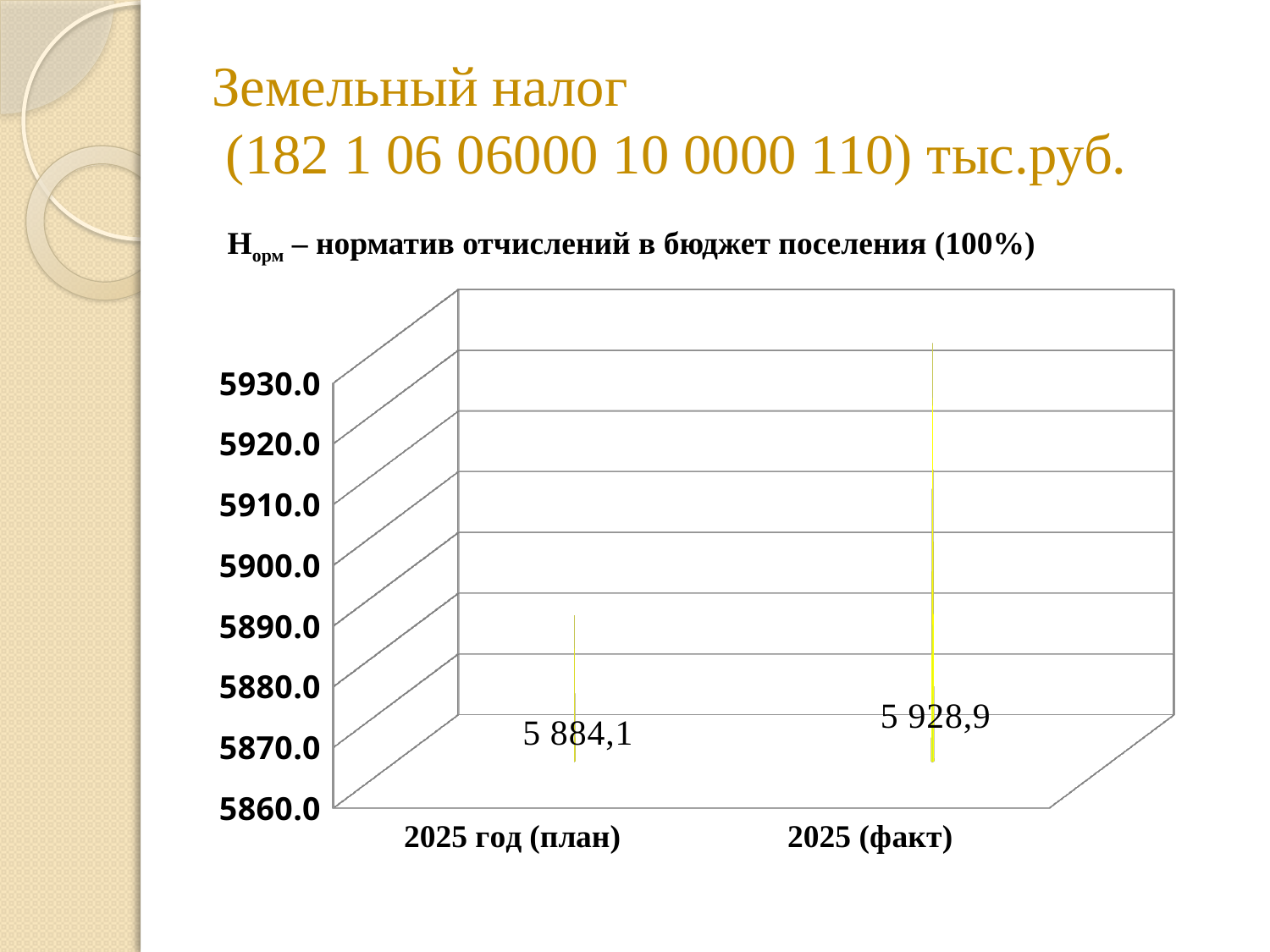
What kind of chart is shown on the slide? bar chart What is the difference between the value for 2025 (факт) and the value for 2025 год (план)? 44,8 Is the value for 2025 (факт) greater or less than 5900.0? greater Is the value for 2025 год (план) greater or less than 5900.0? less Which category has the lower value? 2025 год (план) Do the values rise or fall from 2025 год (план) to 2025 (факт)? rise What is the value for 2025 (факт)? 5 928,9 What is the lowest value shown on the vertical axis of the chart? 5860.0 What is the value for 2025 год (план)? 5 884,1 Which category has the higher value? 2025 (факт) Is the value for 2025 (факт) larger or smaller than the value for 2025 год (план)? larger How many categories are shown on the x axis of the chart? 2